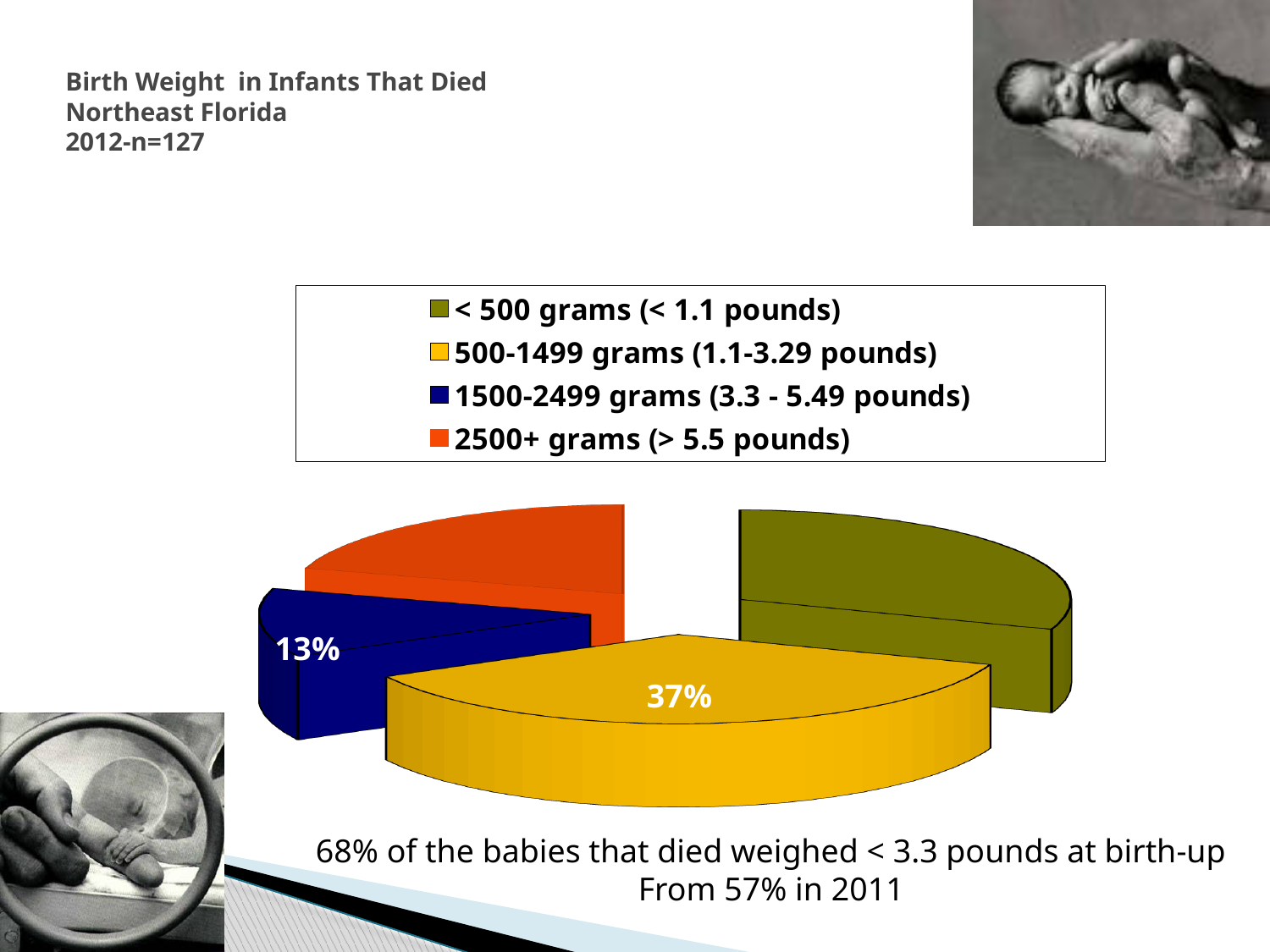
Which slice is larger: 500-1499 grams or 1500-2499 grams? 500-1499 grams Which slice is larger: 2500+ grams or 1500-2499 grams? 2500+ grams Which birth weight category has the largest share of the pie? 500-1499 grams (1.1-3.29 pounds) What is the sample size (n) stated in the chart title? 127 How many entries does the legend list? 4 What percentage of infants that died weighed 500-1499 grams (1.1-3.29 pounds)? 37% What colour represents the 2500+ grams (> 5.5 pounds) category in the legend? orange What kind of chart is shown on the slide? pie chart Which birth weight category has the smallest share of the pie? 1500-2499 grams (3.3 - 5.49 pounds) What is the difference in percentage points between the 500-1499 grams slice and the 1500-2499 grams slice? 24 percentage points How many categories does the pie chart show? 4 What percentage of infants that died weighed 1500-2499 grams (3.3 - 5.49 pounds)? 13%